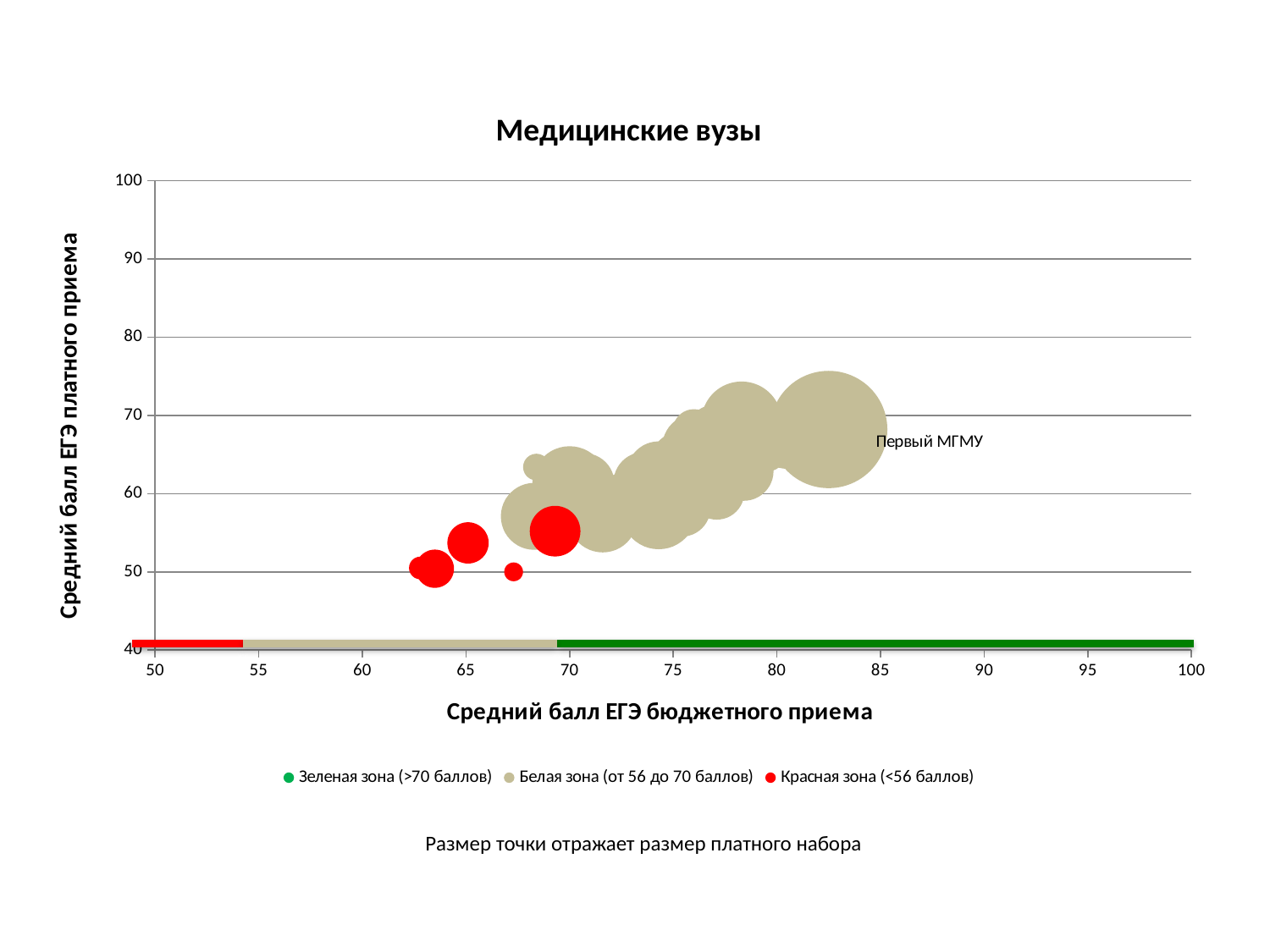
How many series does the legend list? 3 What is the label of the x axis? Средний балл ЕГЭ бюджетного приема Is the y-axis value (Средний балл ЕГЭ платного приема) for Первый МГМУ greater or less than 60? greater Do the y-axis values of the points generally rise or fall as the x-axis value increases? rise What is the title of the chart? Медицинские вузы What kind of chart is shown on the slide? bubble chart Is the x-axis value for Первый МГМУ greater or less than 90? less Is the x-axis value (Средний балл ЕГЭ бюджетного приема) for Первый МГМУ greater or less than 80? greater Which legend entry corresponds to the red points? Красная зона (<56 баллов)